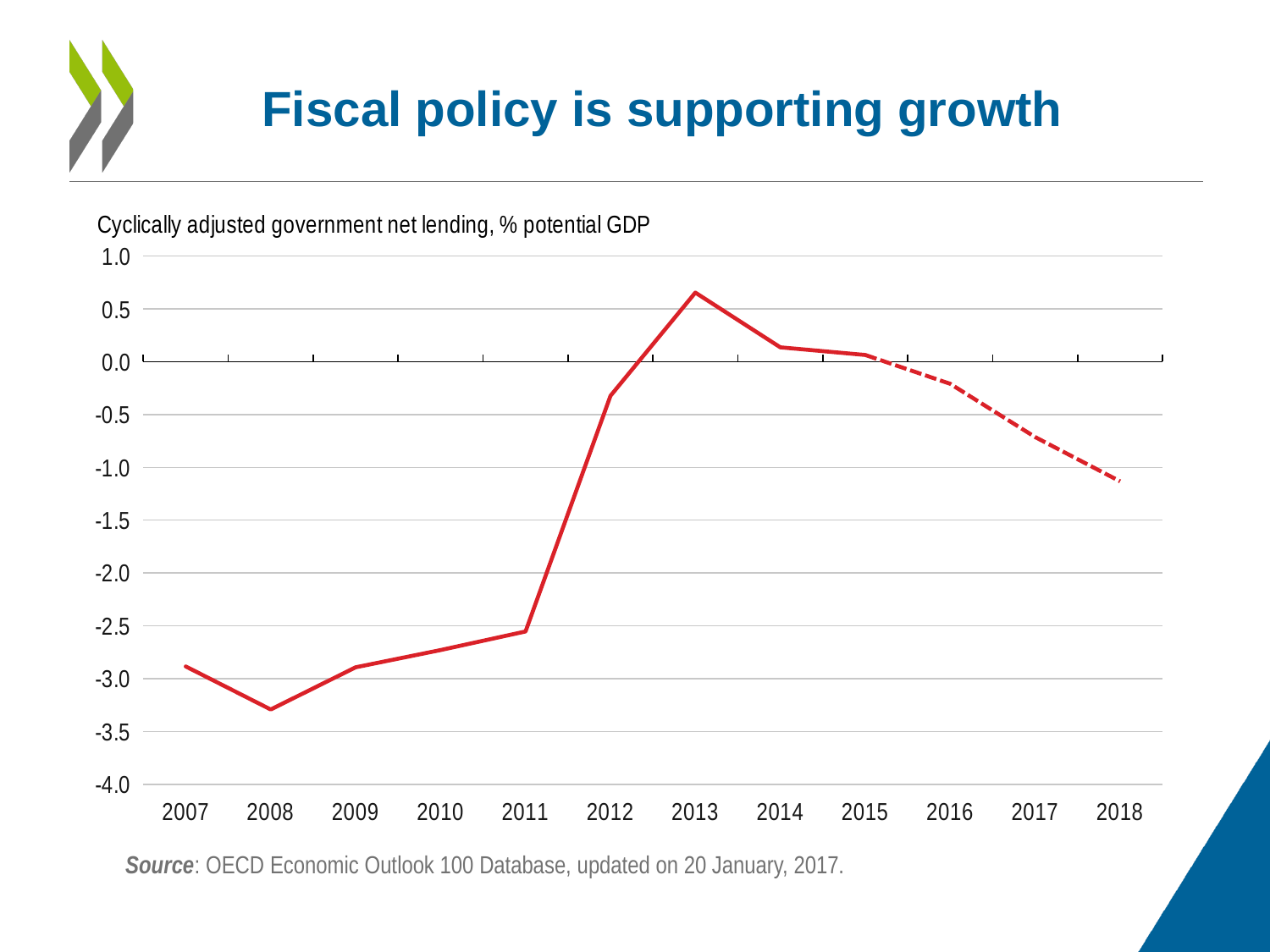
Is the value for 2008 greater or less than -3.0? less Is the value for 2016 greater or less than 0.0? less Is the value for 2012 greater or less than -0.5? greater What kind of chart is shown on the slide? line chart Does the line rise or fall between 2013 and 2018? fall Which year has the larger value, 2008 or 2009? 2009 In which year does cyclically adjusted government net lending reach its highest value? 2013 In which year does cyclically adjusted government net lending reach its lowest value? 2008 Which year has the larger value, 2013 or 2014? 2013 How many years are shown on the x axis? 12